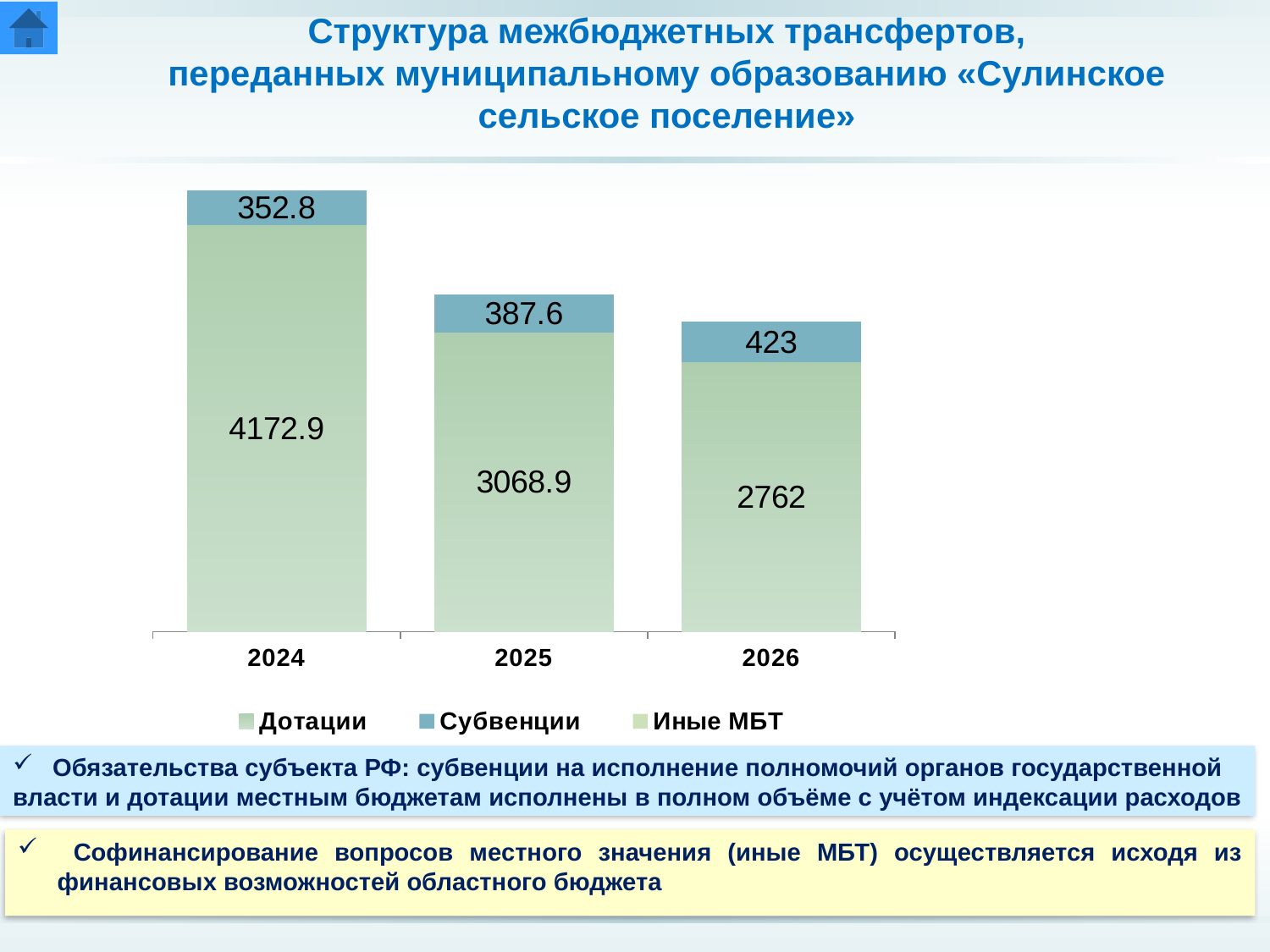
What is the value of Дотации for 2024? 4172.9 Which year has the highest value for Дотации? 2024 Which is larger: Субвенции in 2025 or Субвенции in 2026? Субвенции in 2026 What is the difference between the Дотации values for 2024 and 2025? 1104 Do the Дотации values rise or fall from 2024 to 2026? Fall What kind of chart is shown on the slide? Stacked bar chart What is the value of Субвенции for 2026? 423 How many series does the legend list? 3 Which year has the lowest value for Субвенции? 2024 What is the value of Дотации for 2025? 3068.9 What is the total of the stacked bar for 2026? 3185 How many years are shown on the x axis? 3